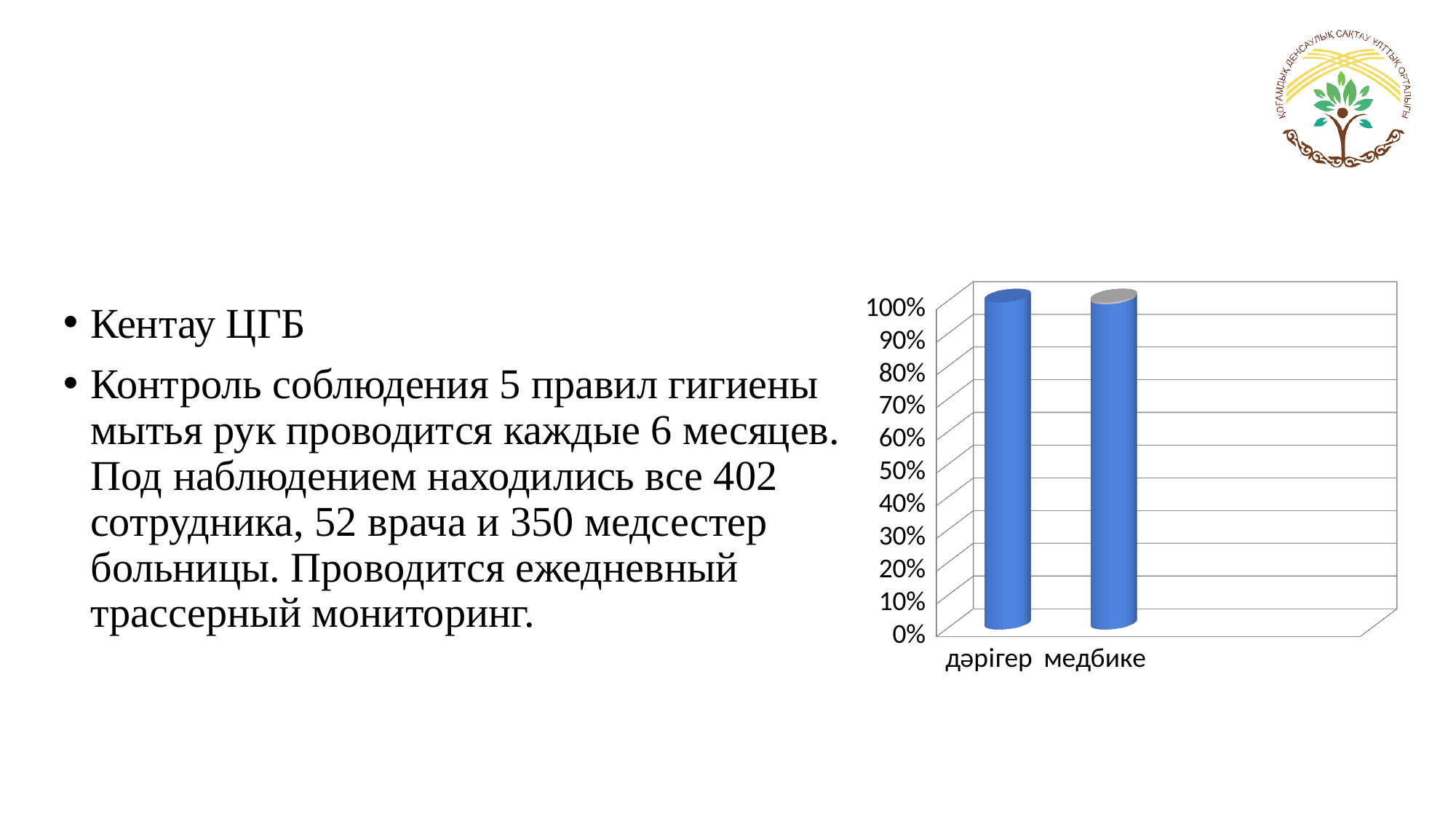
Is the value for дәрігер greater or less than 50%? greater Is the value for дәрігер greater or less than 90%? greater What kind of chart is shown on the slide? bar chart Is the value for медбике greater or less than 90%? greater How many categories are plotted on the chart? 2 What are the two category labels on the x axis of the chart? дәрігер, медбике What is the highest tick value shown on the chart's vertical axis? 100%